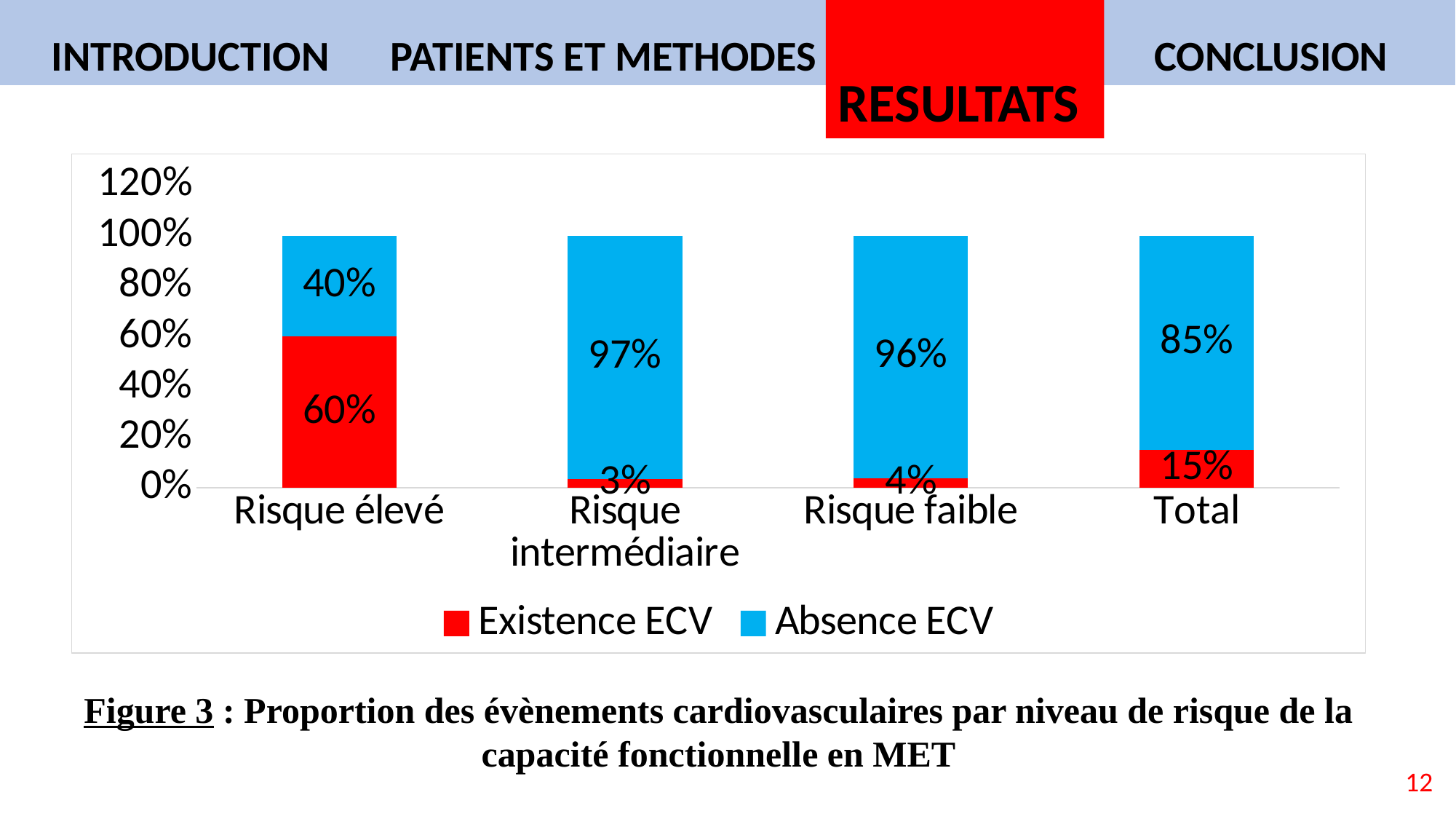
Which is larger: the Absence ECV value for Risque intermédiaire or for Risque faible? Risque intermédiaire How many categories are shown on the x axis? 4 What is the value for Existence ECV in the Risque faible category? 4% Which category has the lowest value for Existence ECV? Risque intermédiaire What kind of chart is shown on the slide? Stacked bar chart What is the value for Absence ECV in the Total category? 85% What is the difference between the Existence ECV values for Risque élevé and Total? 45% What is the value for Existence ECV in the Risque élevé category? 60% What is the value for Absence ECV in the Risque intermédiaire category? 97% Which colour represents Existence ECV in the chart? Red How many series does the legend list? 2 Which category has the highest value for Existence ECV? Risque élevé